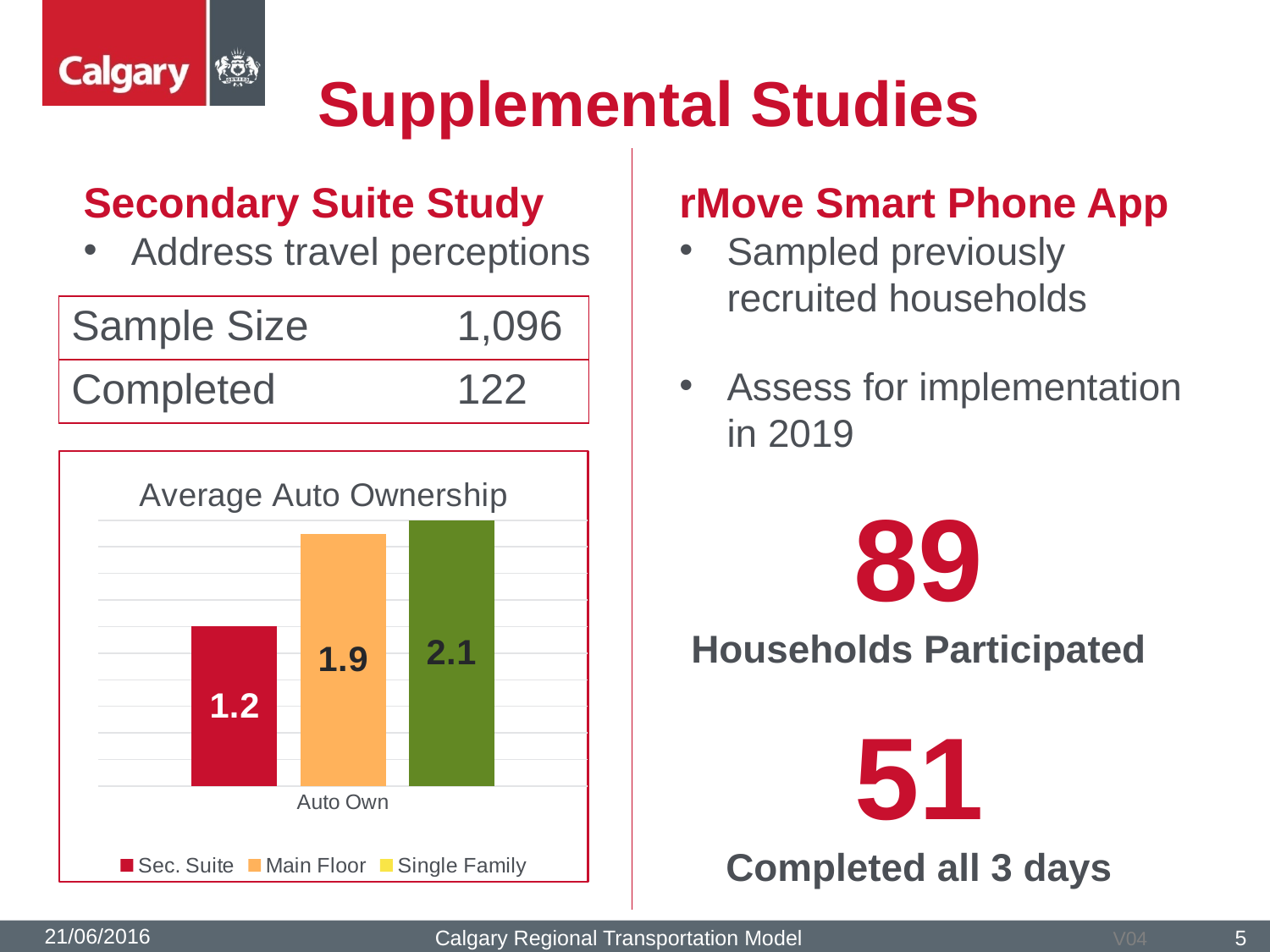
How many series does the legend of the Average Auto Ownership chart list? 3 What is the average auto ownership for Main Floor in the Average Auto Ownership chart? 1.9 What is the average auto ownership for Single Family in the Average Auto Ownership chart? 2.1 What is the x-axis category label in the Average Auto Ownership chart? Auto Own In the Average Auto Ownership chart, which is larger: Main Floor or Sec. Suite? Main Floor Which series has the highest value in the Average Auto Ownership chart? Single Family Which series has the lowest value in the Average Auto Ownership chart? Sec. Suite How many categories are shown on the x axis of the Average Auto Ownership chart? 1 What is the difference between the Main Floor and Sec. Suite values in the Average Auto Ownership chart? 0.7 What type of chart is the Average Auto Ownership chart? Bar chart What is the average auto ownership for Sec. Suite in the Average Auto Ownership chart? 1.2 What is the difference between the Single Family and Sec. Suite values in the Average Auto Ownership chart? 0.9